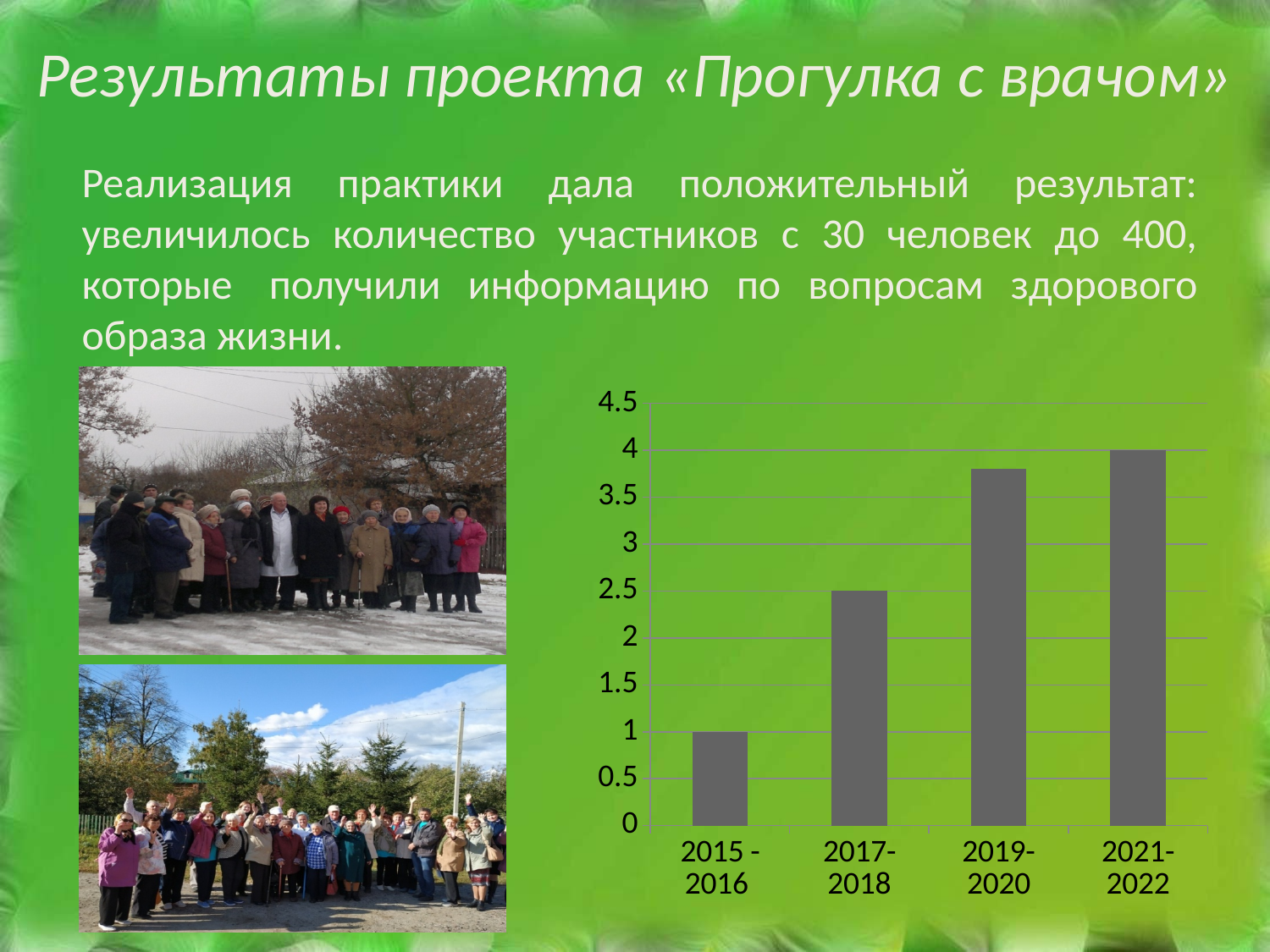
What is the value for 2017-2018? 2.5 How many periods are shown on the x axis? 4 Which is larger, the value for 2017-2018 or the value for 2015 - 2016? 2017-2018 What is the value for 2021-2022? 4 Which period has the highest value? 2021-2022 Is the value for 2019-2020 greater or less than 3.5? greater What kind of chart is shown on the slide? bar chart Is the value for 2019-2020 greater or less than 4? less What is the value for 2015 - 2016? 1 Do the values rise or fall from 2015 - 2016 to 2021-2022? rise What is the difference between the values for 2021-2022 and 2015 - 2016? 3 Which period has the lowest value? 2015 - 2016